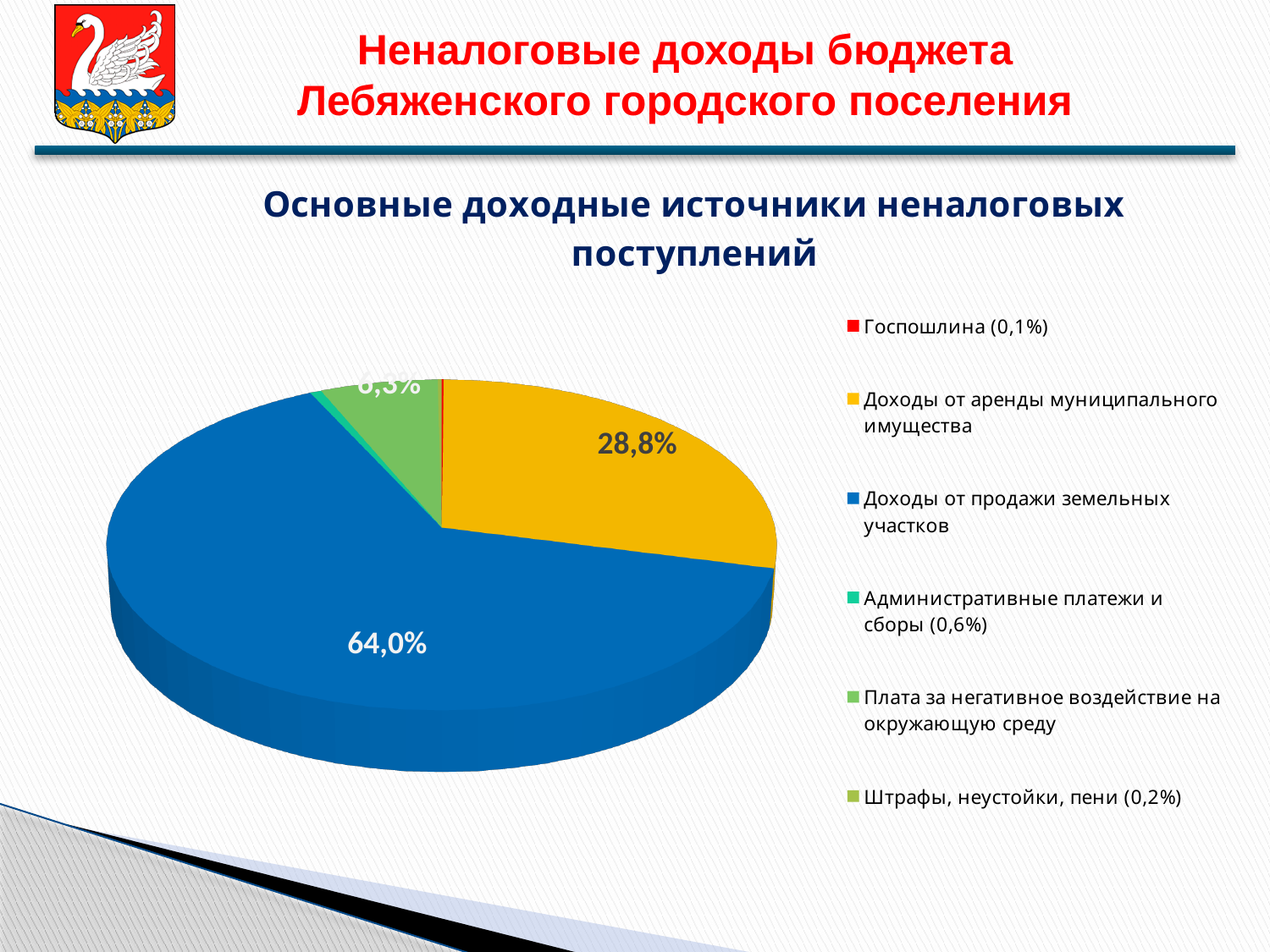
Which revenue source has the largest slice of the pie? Доходы от продажи земельных участков Which is larger: the share of Административные платежи и сборы or the share of Штрафы, неустойки, пени? Административные платежи и сборы What share of non-tax revenue comes from Доходы от аренды муниципального имущества? 28,8% What share is shown in the legend for Госпошлина? 0,1% What share is shown in the legend for Штрафы, неустойки, пени? 0,2% What kind of chart is shown on the slide? pie chart What colour is the slice for Доходы от аренды муниципального имущества? yellow What is the difference in percentage points between Доходы от продажи земельных участков and Доходы от аренды муниципального имущества? 35,2 What share is shown in the legend for Административные платежи и сборы? 0,6% Which revenue source has the smallest share according to the legend? Госпошлина What share of non-tax revenue comes from Доходы от продажи земельных участков? 64,0% How many revenue sources does the legend list? 6